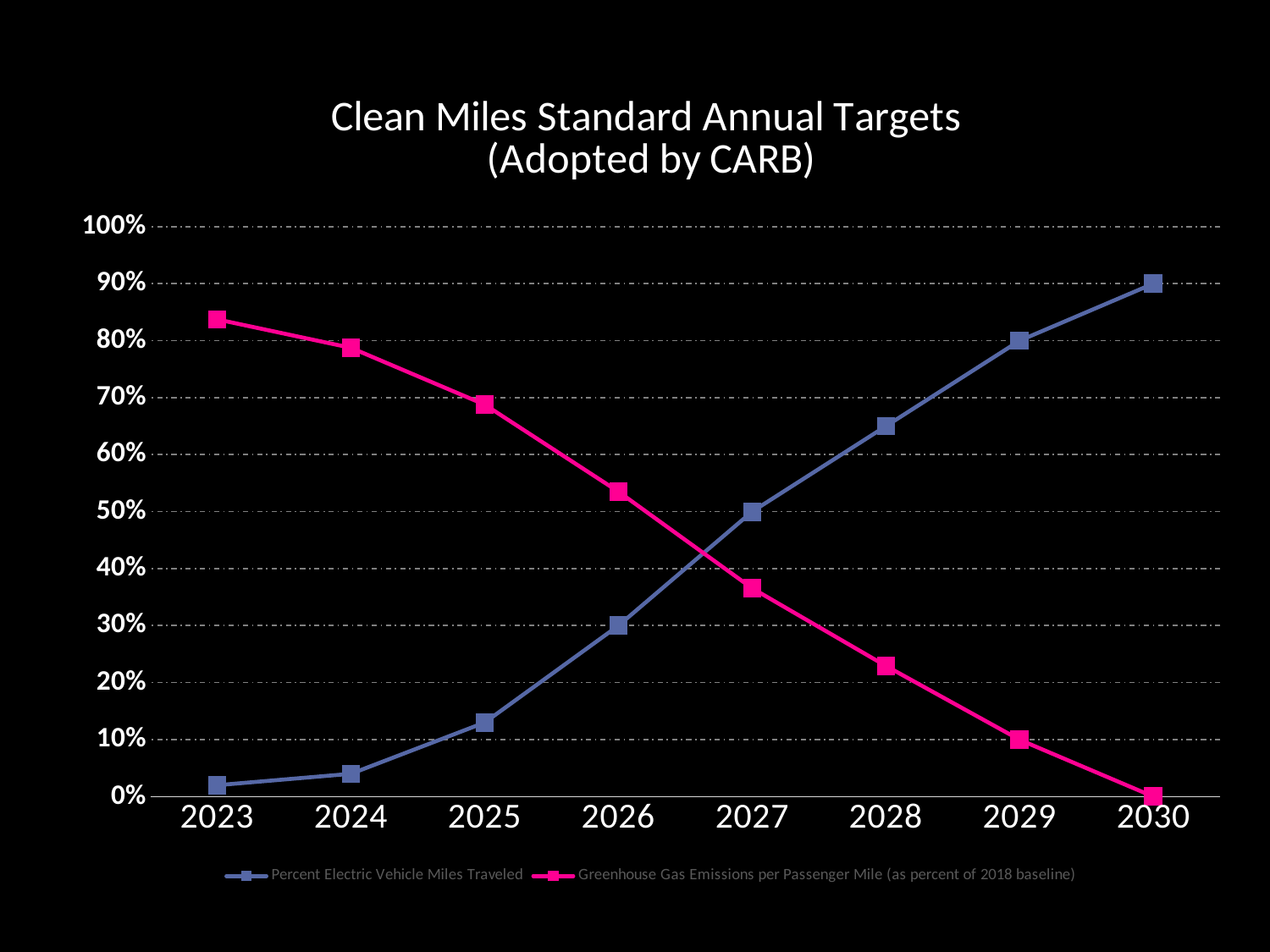
What is the title of the chart? Clean Miles Standard Annual Targets (Adopted by CARB) How many years are plotted along the x axis? 8 Is the Greenhouse Gas Emissions per Passenger Mile value for 2023 greater or less than 80%? greater What is the Greenhouse Gas Emissions per Passenger Mile target for 2030? 0% Is the Percent Electric Vehicle Miles Traveled value for 2025 greater or less than 20%? less What kind of chart is shown on the slide? line chart Does the Percent Electric Vehicle Miles Traveled series rise or fall from 2023 to 2030? rise Does the Greenhouse Gas Emissions per Passenger Mile series rise or fall from 2023 to 2030? fall In 2028, which series has the larger value: Percent Electric Vehicle Miles Traveled or Greenhouse Gas Emissions per Passenger Mile? Percent Electric Vehicle Miles Traveled What is the Percent Electric Vehicle Miles Traveled target for 2030? 90% What is the Percent Electric Vehicle Miles Traveled target for 2027? 50% How many series does the legend list? 2